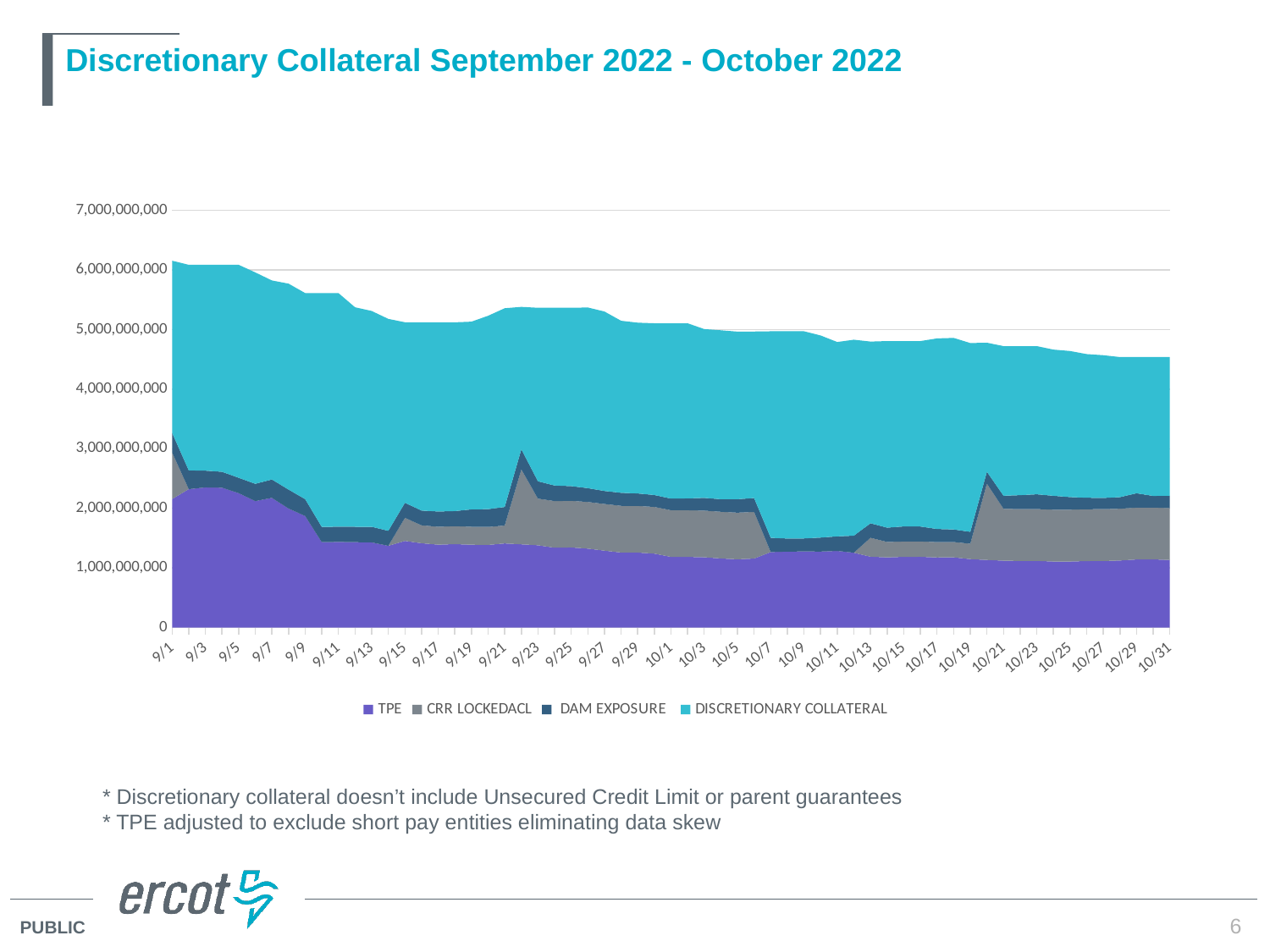
What kind of chart is shown on the slide? Stacked area chart What is the highest value shown on the y axis? 7,000,000,000 Which is larger on 9/1: the TPE value or the DISCRETIONARY COLLATERAL value? DISCRETIONARY COLLATERAL Does the total stacked value rise or fall from 9/1 to 10/31? Fall Is the TPE value on 9/3 greater or less than 2,000,000,000? greater How many series does the legend list? 4 Which series is shown in the light teal colour at the top of the stack? DISCRETIONARY COLLATERAL Which series occupies the largest area of the chart? DISCRETIONARY COLLATERAL What is the title of the chart? Discretionary Collateral September 2022 - October 2022 Is the total stacked value on 9/1 greater or less than 5,000,000,000? greater Is the total stacked value on 10/31 greater or less than 5,000,000,000? less